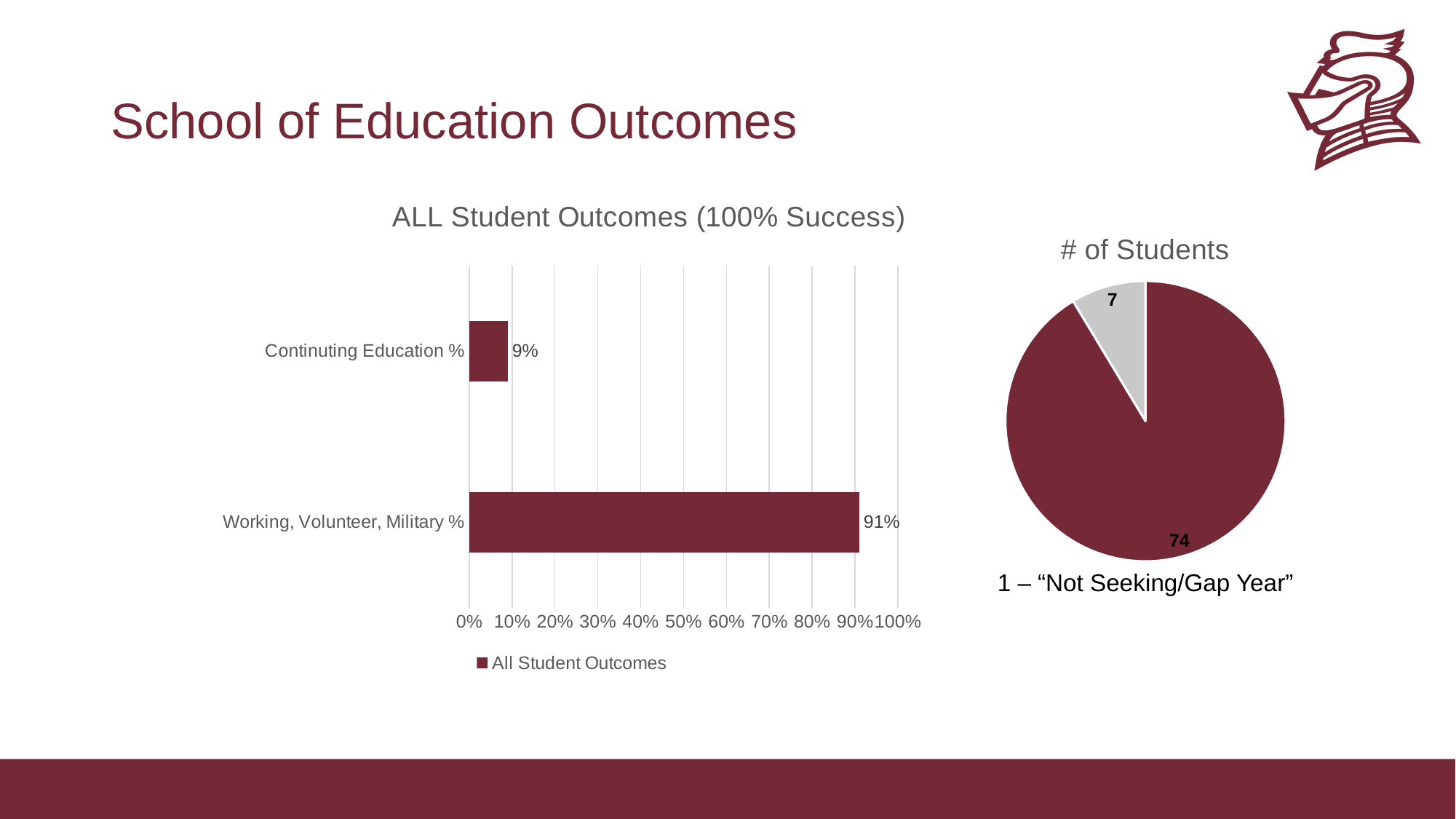
What kind of chart is the 'ALL Student Outcomes (100% Success)' chart? bar chart In the 'ALL Student Outcomes (100% Success)' chart, which category has the lowest value? Continuting Education % In the 'ALL Student Outcomes (100% Success)' chart, what is the value for Working, Volunteer, Military %? 91% What series name does the legend of the 'ALL Student Outcomes (100% Success)' chart list? All Student Outcomes In the '# of Students' pie chart, what is the value of the smaller (grey) slice? 7 In the 'ALL Student Outcomes (100% Success)' chart, which category has the highest value? Working, Volunteer, Military % In the '# of Students' pie chart, what is the value of the larger (maroon) slice? 74 In the 'ALL Student Outcomes (100% Success)' chart, what is the difference between the Working, Volunteer, Military % value and the Continuting Education % value? 82% In the 'ALL Student Outcomes (100% Success)' chart, what is the value for Continuting Education %? 9% What kind of chart is the '# of Students' chart? pie chart In the '# of Students' pie chart, what is the difference between the two slice values? 67 In the 'ALL Student Outcomes (100% Success)' chart, how many categories are shown? 2